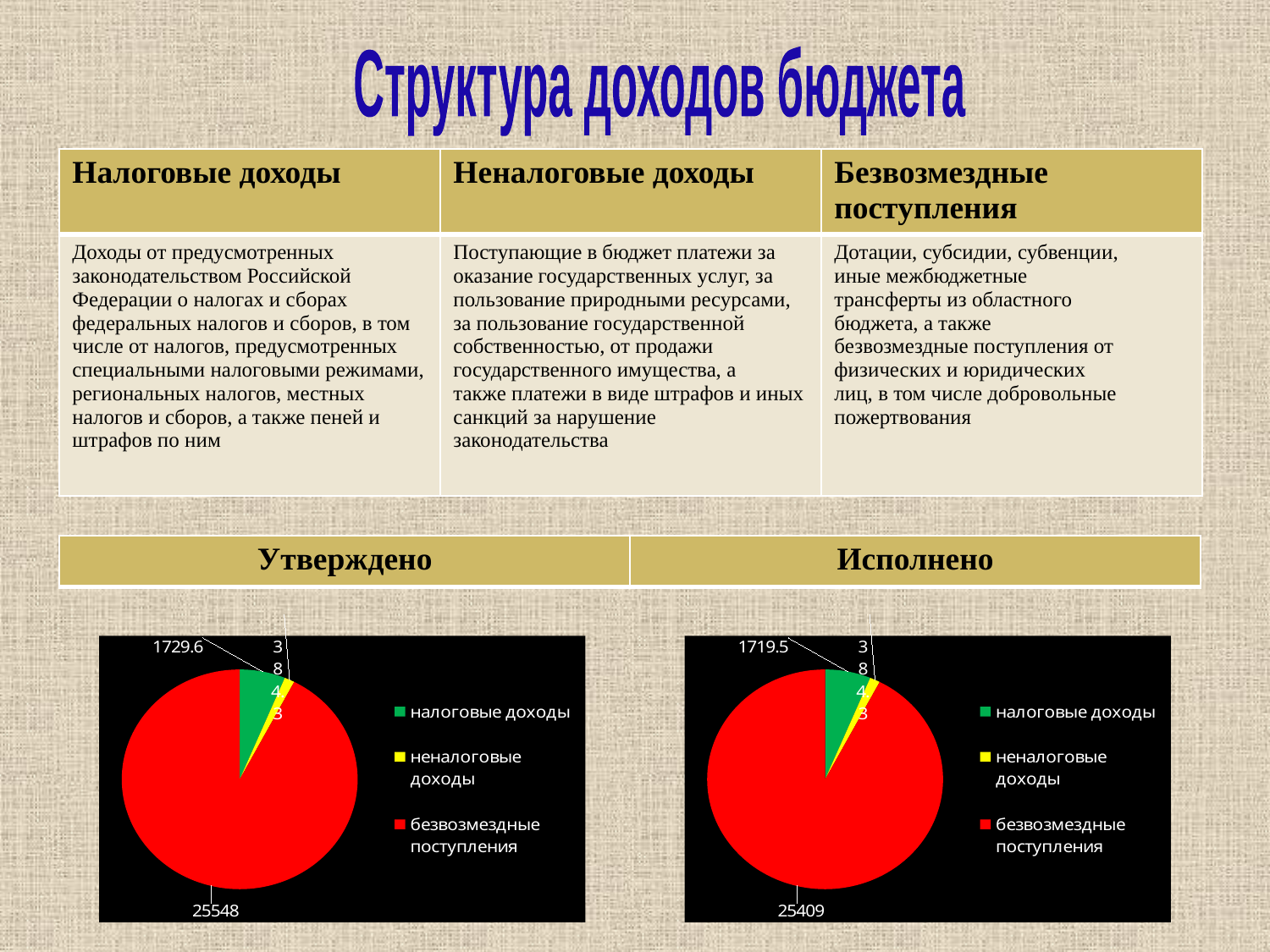
In the "Утверждено" pie chart, what colour represents налоговые доходы? Green How many entries does the legend of the "Исполнено" chart list? 3 In the "Утверждено" pie chart, which category has the largest slice? безвозмездные поступления What is the difference between the безвозмездные поступления value in the "Утверждено" chart and in the "Исполнено" chart? 139 In the "Утверждено" pie chart, what is the value for налоговые доходы? 1729.6 In the "Утверждено" pie chart, what is the value for безвозмездные поступления? 25548 In the "Утверждено" pie chart, which is larger: налоговые доходы or безвозмездные поступления? безвозмездные поступления What type of chart is used under "Утверждено" and "Исполнено"? Pie chart In the "Исполнено" pie chart, what is the value for безвозмездные поступления? 25409 In the "Исполнено" pie chart, what is the value for налоговые доходы? 1719.5 How many slices does the "Утверждено" pie chart have? 3 In the "Исполнено" pie chart, which category has the smallest slice? неналоговые доходы